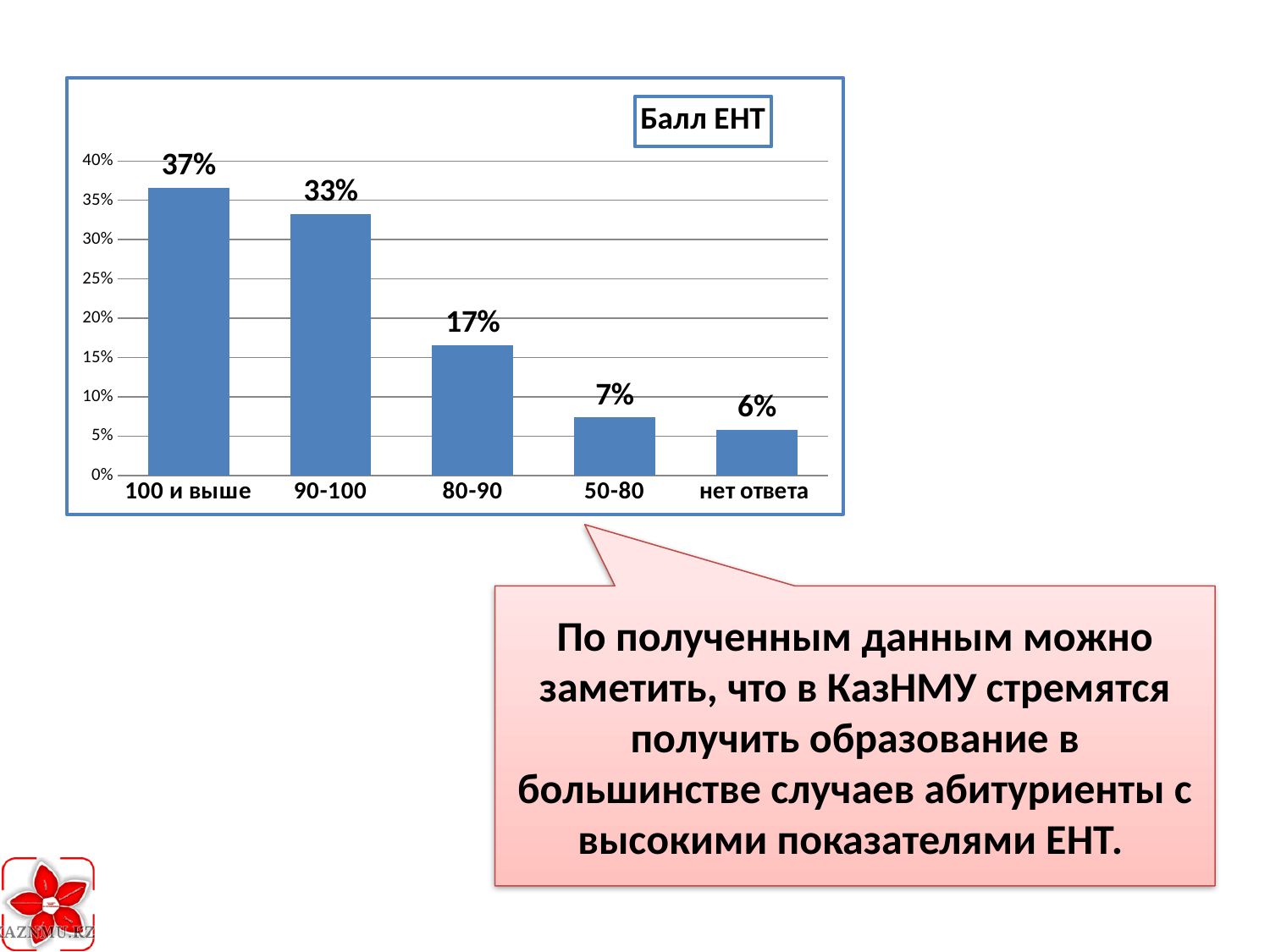
How many categories are shown on the x axis? 5 What is the value for the category "80-90"? 17% Is the value for "90-100" greater or less than 30%? greater What kind of chart is shown on the slide? bar chart Do the values rise or fall from left to right along the x axis? fall Which is larger: the value for "50-80" or the value for "нет ответа"? 50-80 What is the value for the category "нет ответа"? 6% What is the value for the category "100 и выше"? 37% Which category has the highest value? 100 и выше Which category has the lowest value? нет ответа What is the legend entry shown on the chart? Балл ЕНТ What is the difference between the values for "90-100" and "80-90"? 16%